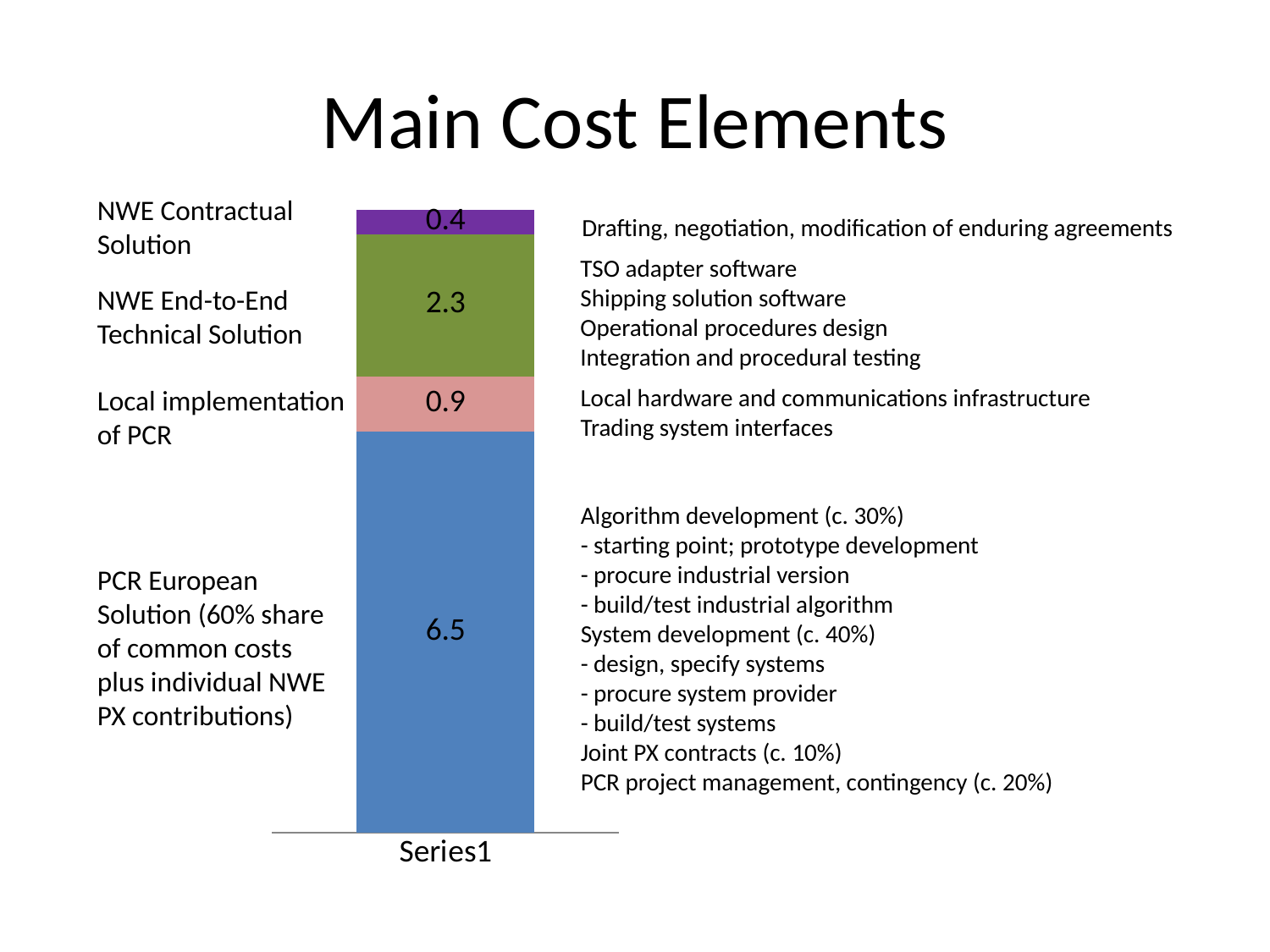
What is the category label shown on the x axis beneath the bar? Series1 What is the total of all segments in the stacked bar? 10.1 What is the difference between the PCR European Solution segment and the NWE End-to-End Technical Solution segment? 4.2 Which is larger, the Local implementation of PCR segment or the NWE Contractual Solution segment? Local implementation of PCR Which cost element has the largest segment in the stacked bar? PCR European Solution What is the value of the Local implementation of PCR segment? 0.9 What is the value of the NWE Contractual Solution segment? 0.4 How many segments make up the stacked bar? 4 What is the value of the NWE End-to-End Technical Solution segment? 2.3 What is the value of the PCR European Solution segment of the stacked bar? 6.5 Which cost element has the smallest segment in the stacked bar? NWE Contractual Solution What type of chart is shown on the slide? Stacked bar chart